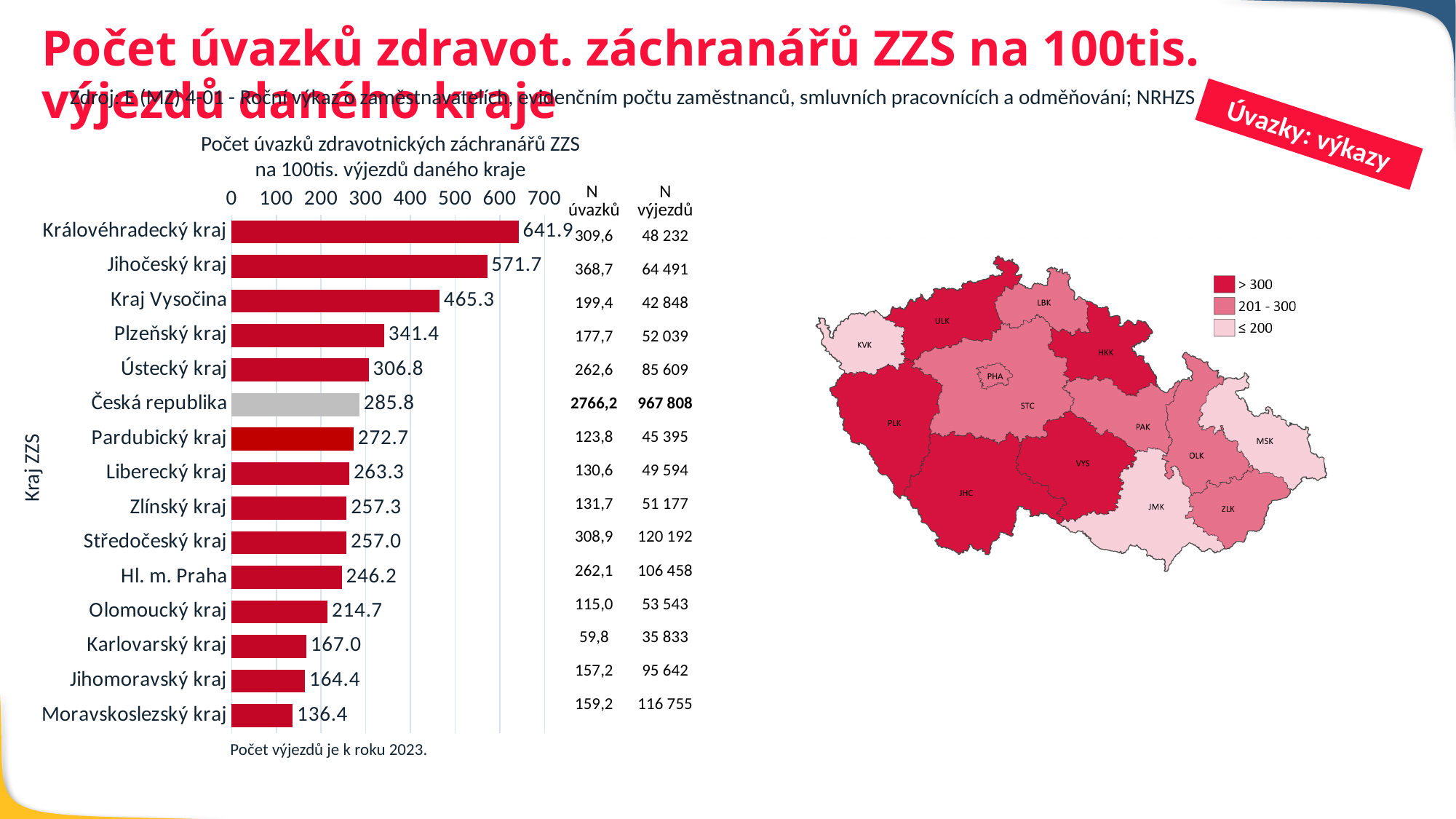
Which category has the highest value in the bar chart? Královéhradecký kraj What is the value for Česká republika in the bar chart? 285.8 Is the value for Olomoucký kraj greater or less than 300? less How many bars are shown in the bar chart? 15 Which has a larger value, Kraj Vysočina or Plzeňský kraj? Kraj Vysočina Which bar in the chart is coloured grey rather than red? Česká republika Which category has the lowest value in the bar chart? Moravskoslezský kraj What is the difference between the values for Plzeňský kraj and Ústecký kraj? 34.6 What is the value for Královéhradecký kraj in the bar chart? 641.9 What is the value for Hl. m. Praha in the bar chart? 246.2 What kind of chart is used to show the number of paramedic positions per 100 thousand call-outs? bar chart What is the difference between the values for Královéhradecký kraj and Jihočeský kraj? 70.2